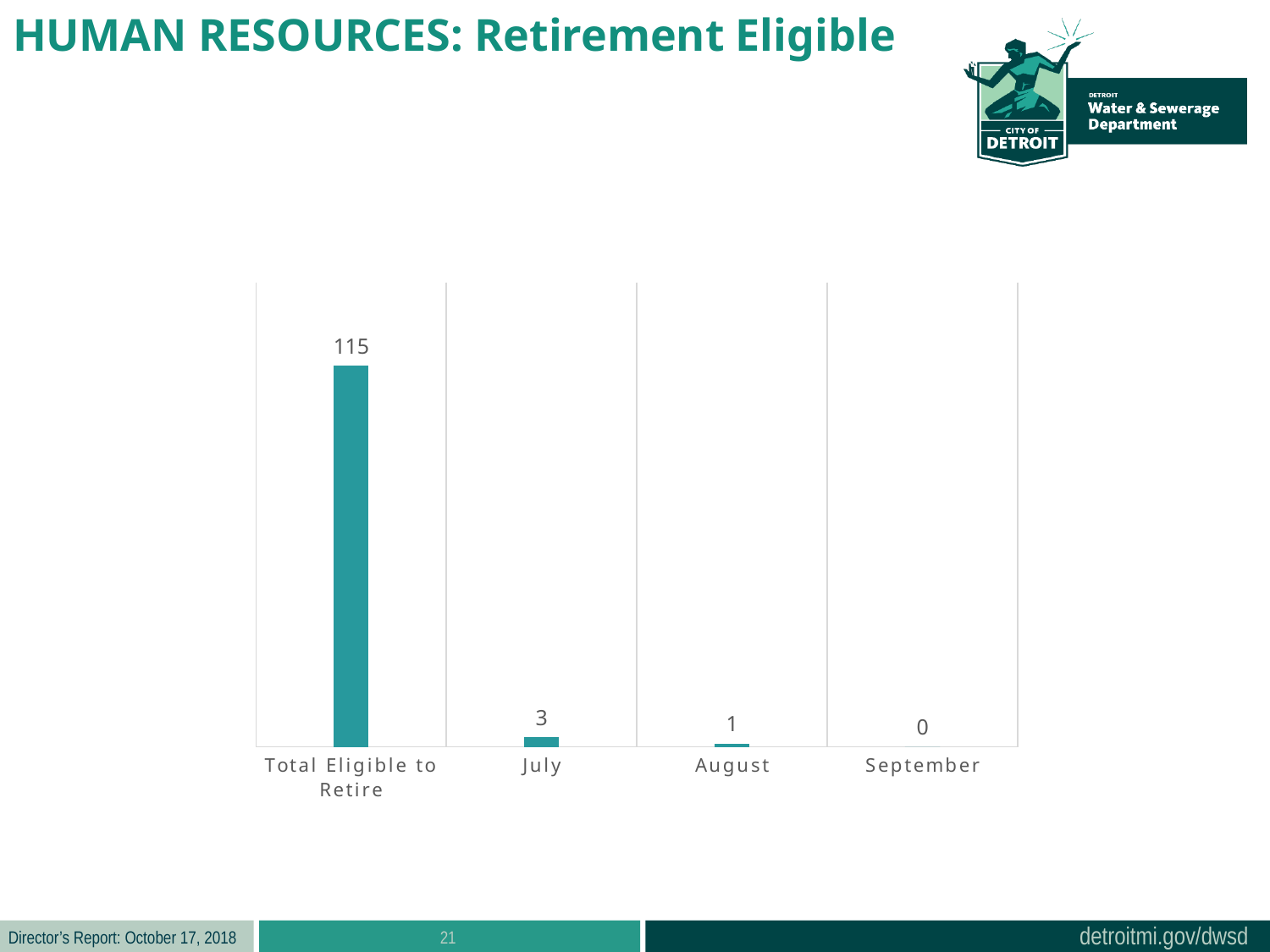
Which category has the highest value? Total Eligible to Retire What is the difference between the values for Total Eligible to Retire and July? 112 How many categories are shown on the x axis? 4 What is the value for July? 3 What is the value for September? 0 What is the value for Total Eligible to Retire? 115 Which is larger, the value for July or the value for August? July What is the value for August? 1 Which category has the lowest value? September Do the values rise or fall from July to September? Fall What kind of chart is shown on the slide? Bar chart What is the difference between the values for July and August? 2